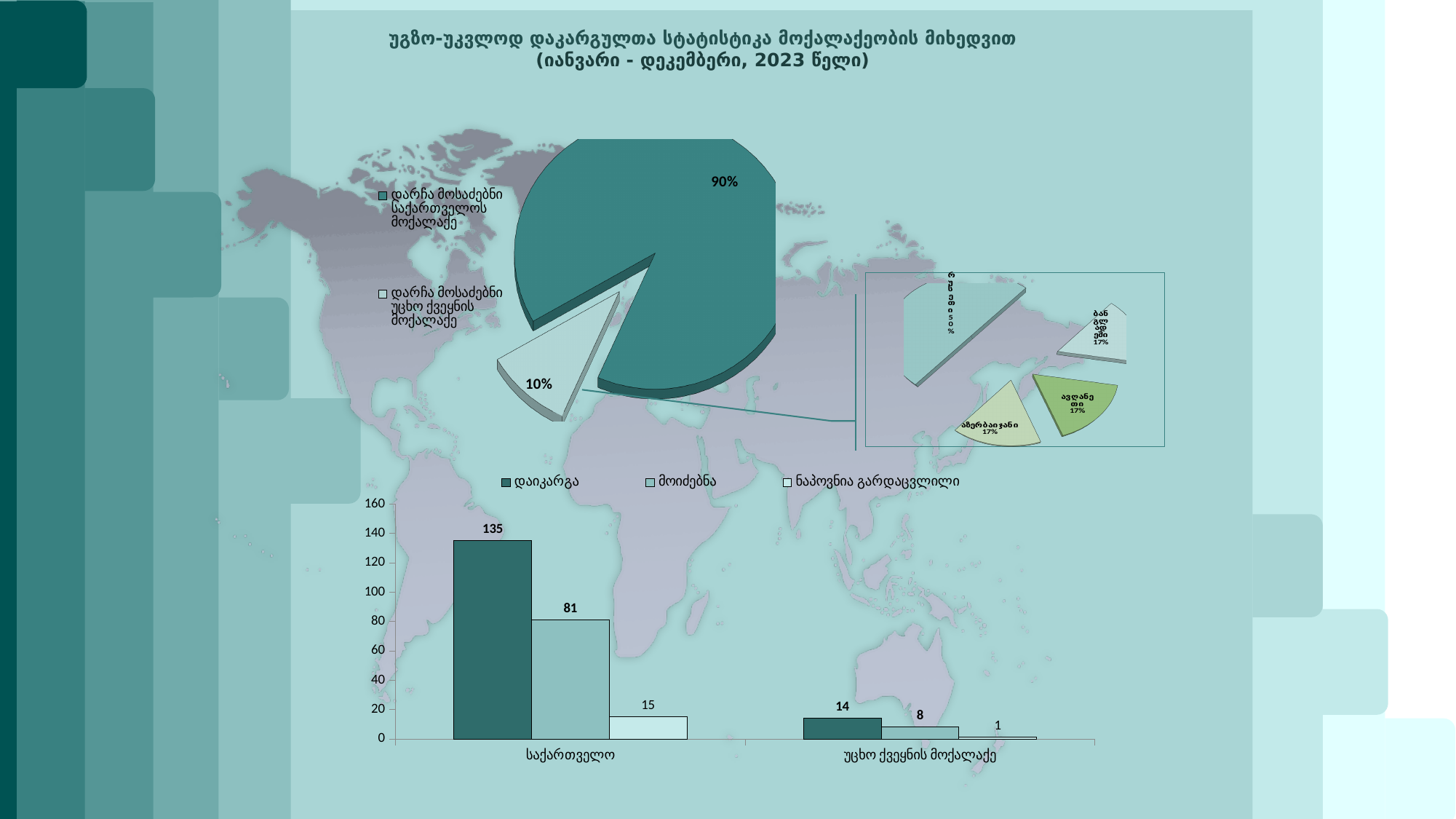
What kind of chart is the lower chart on the slide? bar chart How many categories are shown on the x axis of the bar chart? 2 In the bar chart, what is the value of დაიკარგა for საქართველო? 135 In the bar chart, what is the value of დაიკარგა for უცხო ქვეყნის მოქალაქე? 14 In the bar chart, what is the value of ნაპოვნია გარდაცვლილი for უცხო ქვეყნის მოქალაქე? 1 In the secondary pie breakdown, what share is shown for რუსეთი? 50% How many series does the legend of the bar chart list? 3 In the bar chart, what is the difference between დაიკარგა and მოიძებნა for საქართველო? 54 In the pie chart, what share is shown for დარჩა მოსაძებნი საქართველოს მოქალაქე? 90% In the pie chart, what share is shown for დარჩა მოსაძებნი უცხო ქვეყნის მოქალაქე? 10% In the bar chart, what is the value of მოიძებნა for საქართველო? 81 In the bar chart, which category has the higher value for მოიძებნა, საქართველო or უცხო ქვეყნის მოქალაქე? საქართველო